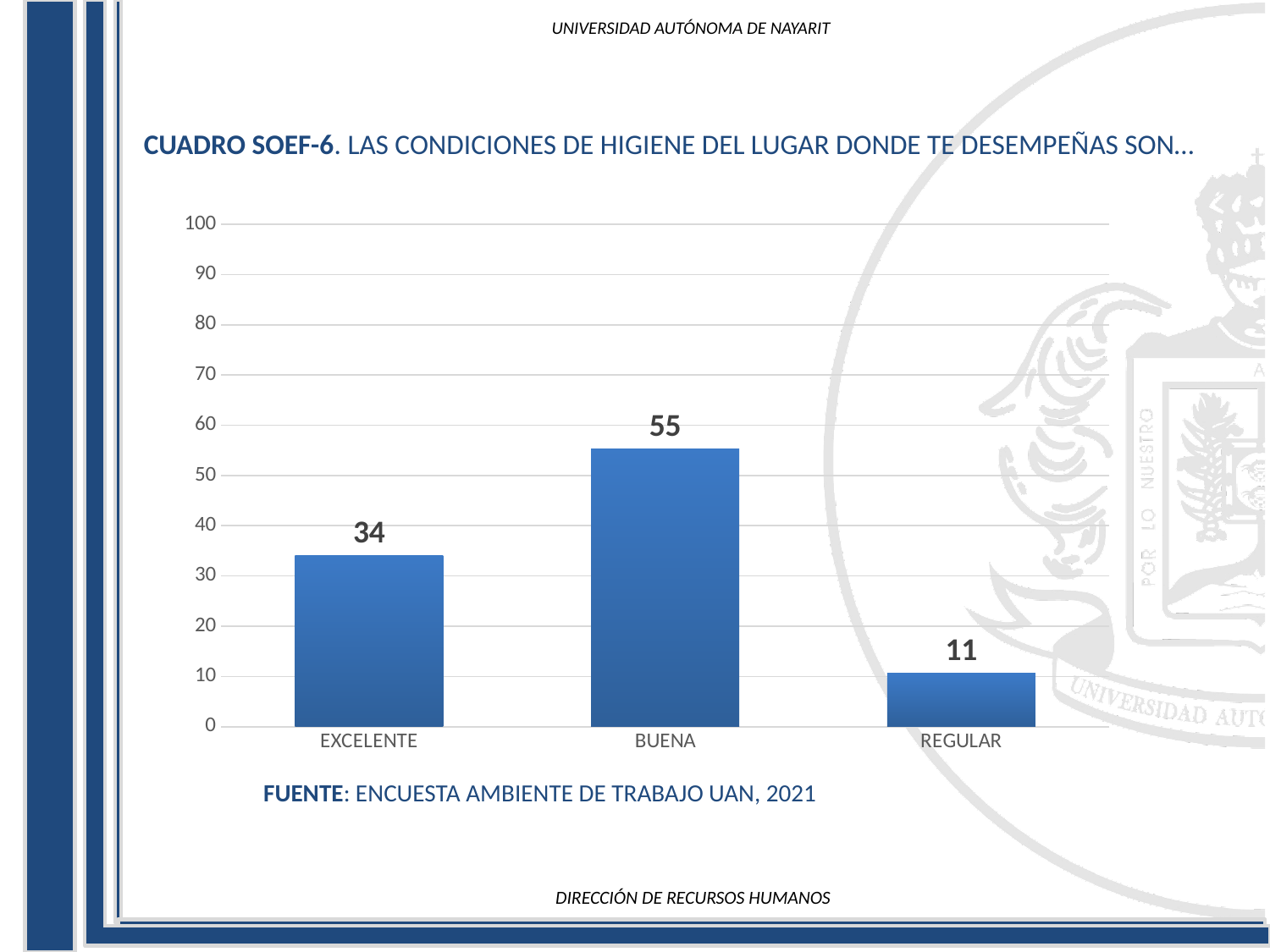
Which is larger, the value for EXCELENTE or the value for REGULAR? EXCELENTE What is the value for REGULAR? 11 Is the value for BUENA greater or less than 50? greater What source is cited below the chart? ENCUESTA AMBIENTE DE TRABAJO UAN, 2021 What is the difference between the values for BUENA and EXCELENTE? 21 What is the value for BUENA? 55 Which category has the highest value? BUENA What is the value for EXCELENTE? 34 How many categories are shown on the x axis? 3 Which category has the lowest value? REGULAR What kind of chart is shown on the slide? bar chart What is the difference between the values for EXCELENTE and REGULAR? 23